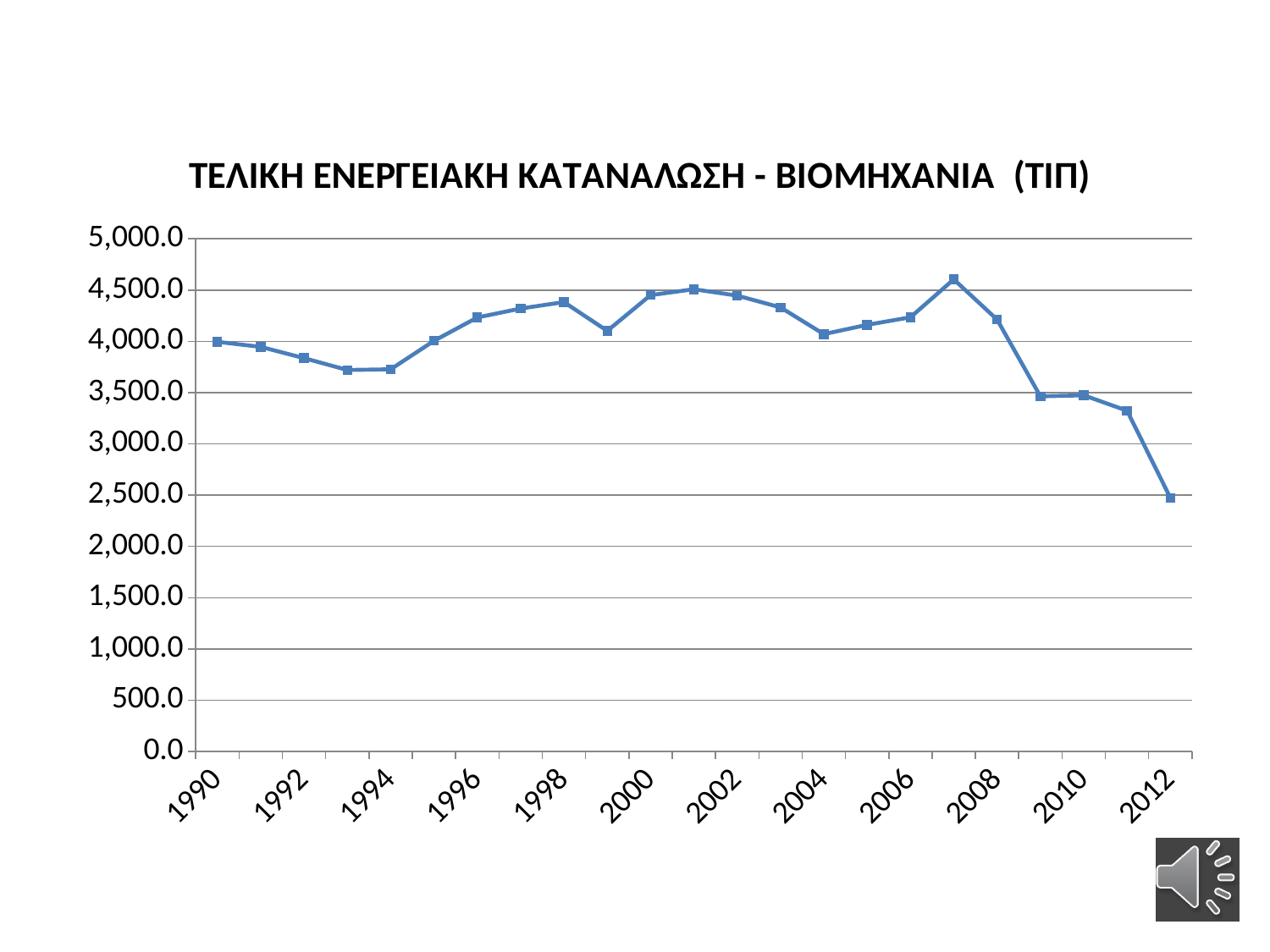
Which year has the highest value? 2007 What is the title of the chart? ΤΕΛΙΚΗ ΕΝΕΡΓΕΙΑΚΗ ΚΑΤΑΝΑΛΩΣΗ - ΒΙΟΜΗΧΑΝΙΑ (ΤΙΠ) Which year has the lowest value? 2012 Is the value for 2011 greater or less than 3,500.0? less Is the value for 2007 greater or less than 4,500.0? greater Which is larger, the value for 1990 or the value for 2012? 1990 What kind of chart is shown on the slide? line chart Do the values rise or fall from 1994 to 1998? rise How many data points are plotted on the line? 23 Is the value for 2012 greater or less than 3,000.0? less Do the values rise or fall from 2008 to 2012? fall